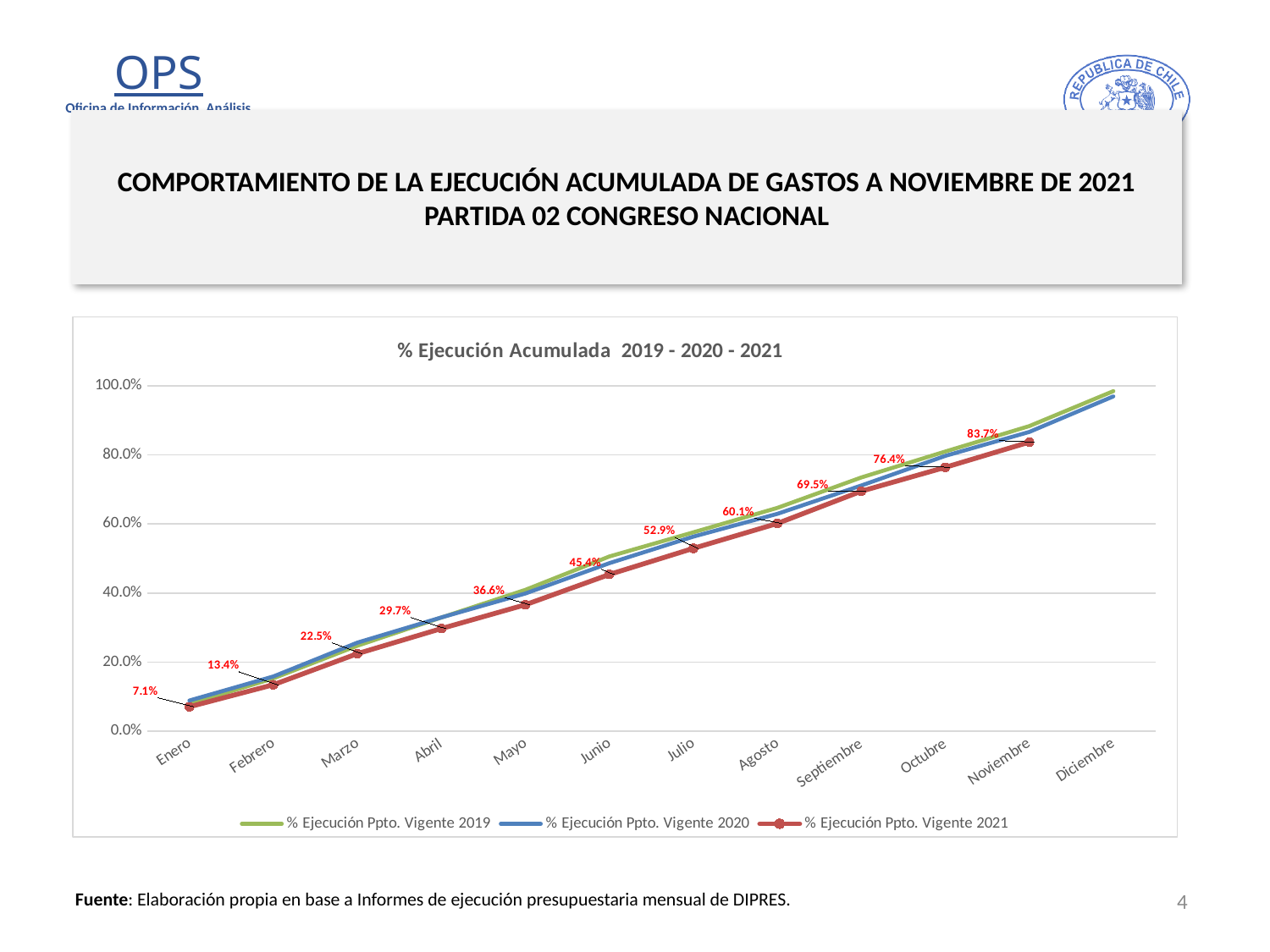
Which is larger in the % Ejecución Ppto. Vigente 2021 series: the value for Marzo or the value for Abril? Abril Which month has the lowest value in the % Ejecución Ppto. Vigente 2021 series? Enero What is the difference between the Noviembre and Octubre values in the % Ejecución Ppto. Vigente 2021 series? 7.3% Do the values in the % Ejecución Ppto. Vigente 2021 series rise or fall from Enero to Noviembre? Rise What kind of chart is shown on the slide? Line chart What is the value for Noviembre in the % Ejecución Ppto. Vigente 2021 series? 83.7% Which month has the highest labelled value in the % Ejecución Ppto. Vigente 2021 series? Noviembre What is the value for Junio in the % Ejecución Ppto. Vigente 2021 series? 45.4% What is the value for Enero in the % Ejecución Ppto. Vigente 2021 series? 7.1% How many series does the legend list? 3 What is the value for Septiembre in the % Ejecución Ppto. Vigente 2021 series? 69.5% Is the value for Diciembre in the % Ejecución Ppto. Vigente 2019 series greater or less than 80.0%? greater